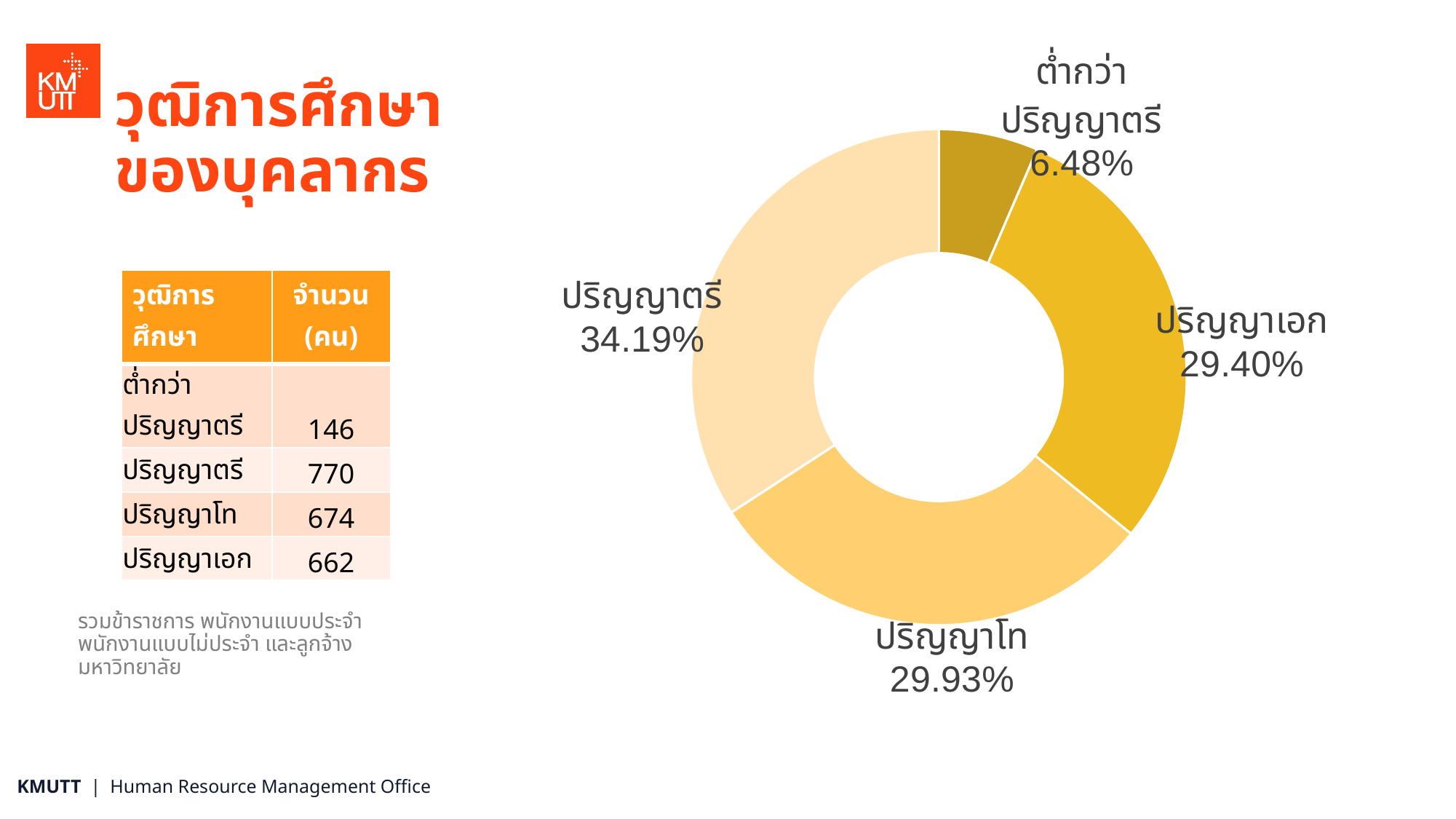
What is the value shown for ปริญญาโท in the pie chart? 29.93% What is the difference in percentage points between ปริญญาตรี and ปริญญาโท? 4.26 What kind of chart is shown on the slide? Pie chart (donut) Which category has the smallest share of the pie chart? ต่ำกว่าปริญญาตรี What share of the pie does ปริญญาตรี have? 34.19% What is the difference in percentage points between ปริญญาตรี and ต่ำกว่าปริญญาตรี? 27.71 What is the value shown for ปริญญาเอก in the pie chart? 29.40% How many categories does the pie chart show? 4 Which category has the largest share of the pie chart? ปริญญาตรี What is the value shown for ต่ำกว่าปริญญาตรี in the pie chart? 6.48% What is the title of the slide containing the pie chart? วุฒิการศึกษาของบุคลากร Which has the larger share, ปริญญาโท or ปริญญาเอก? ปริญญาโท